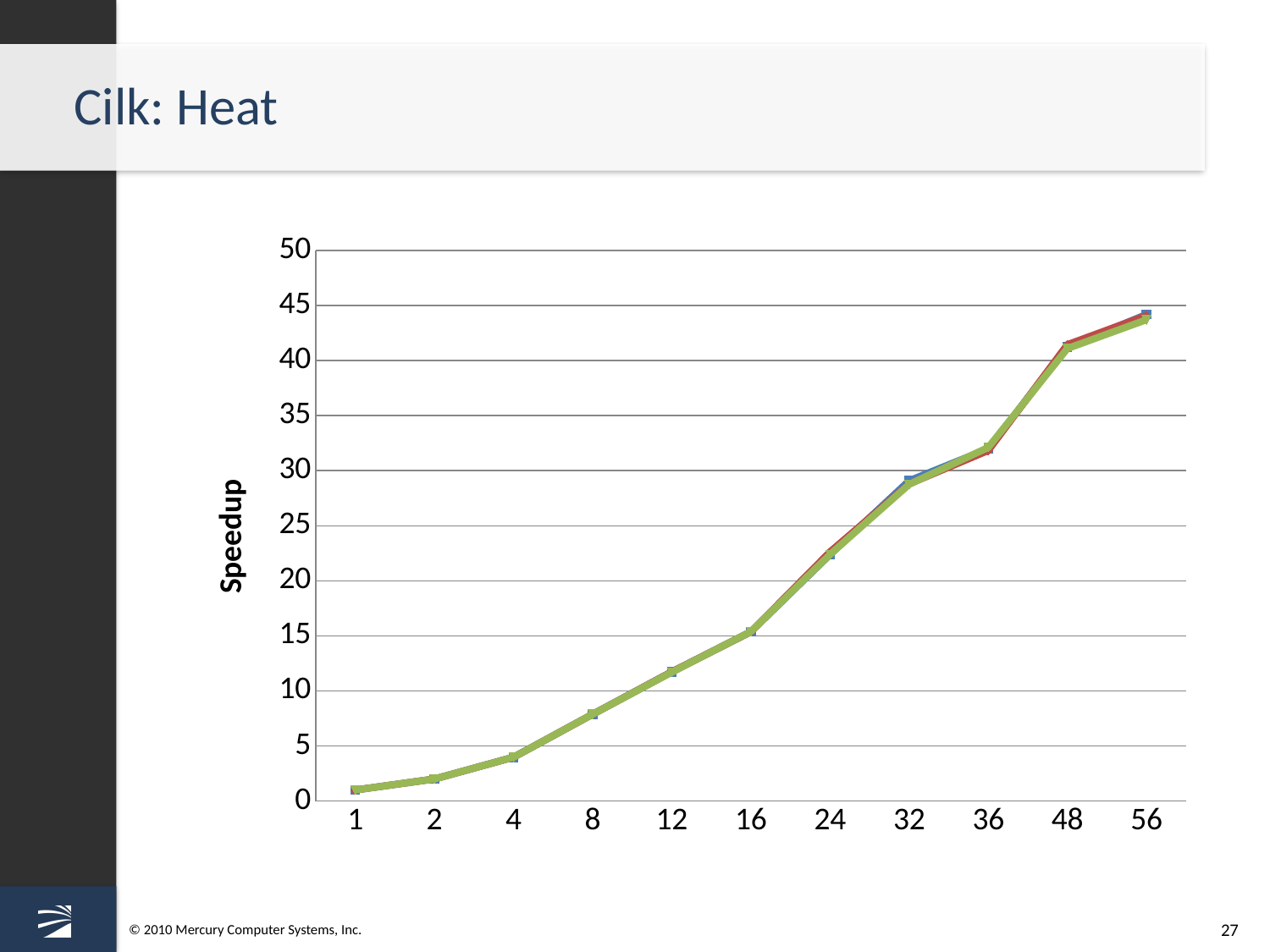
What kind of chart is shown on the slide? line chart What is the label on the y axis of the chart? Speedup Which has the larger speedup, 48 or 36? 48 Is the speedup at 56 greater or less than 40? greater Is the speedup at 8 greater or less than 10? less At which x-axis value is the speedup lowest? 1 Is the speedup at 4 greater or less than 5? less How many points are plotted along the x axis? 11 At which x-axis value is the speedup highest? 56 Do the speedup values rise or fall as the x-axis values increase from 1 to 56? rise